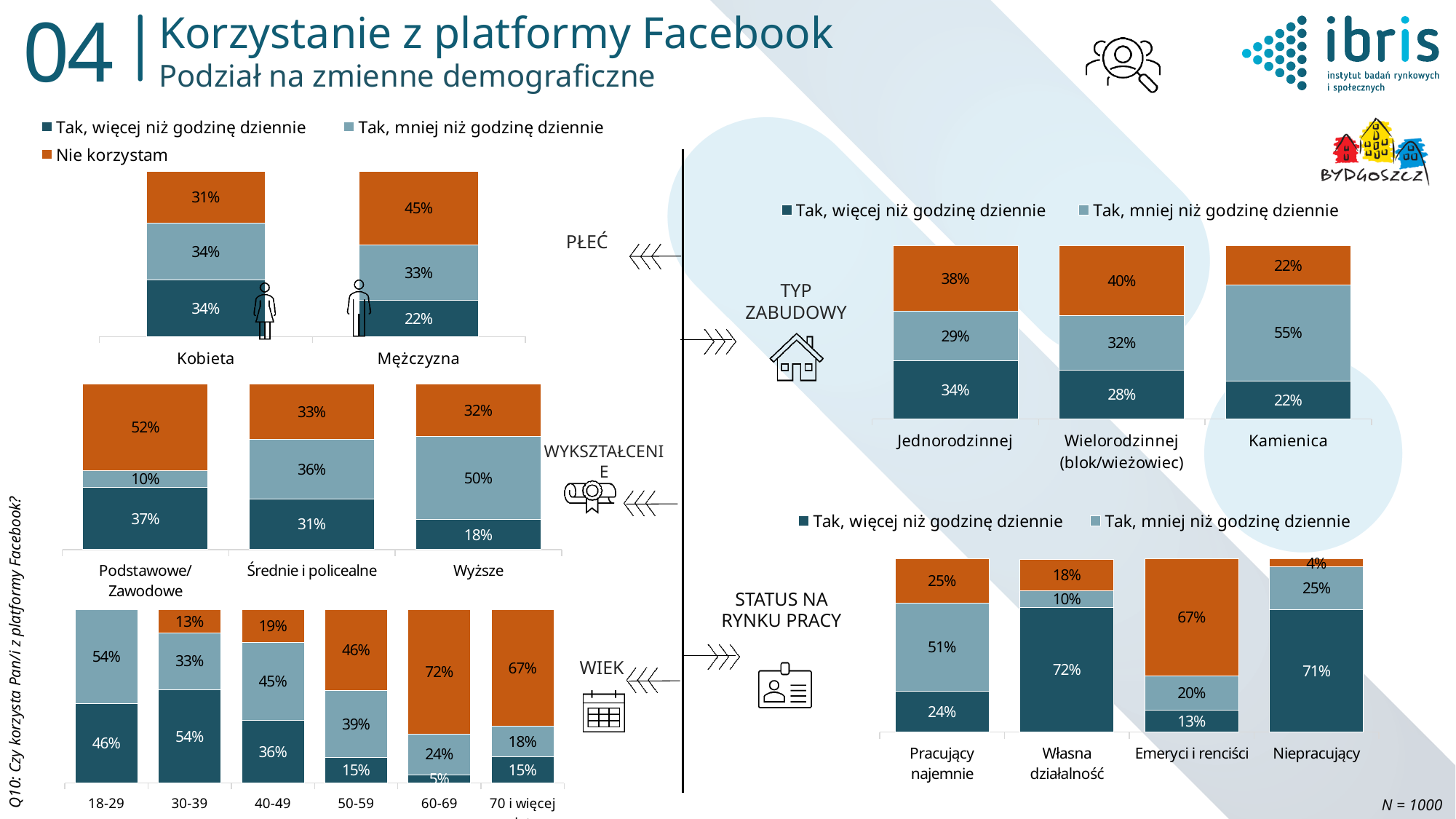
What kind of chart is used in the STATUS NA RYNKU PRACY section? Stacked bar chart In the WIEK chart, which age group has the highest share of 'Nie korzystam'? 60-69 In the WIEK chart, which has the larger share of 'Tak, więcej niż godzinę dziennie': 18-29 or 30-39? 30-39 In the STATUS NA RYNKU PRACY chart, which category has the lowest share of 'Tak, więcej niż godzinę dziennie'? Emeryci i renciści How many series does the legend above the PŁEĆ chart list? 3 In the STATUS NA RYNKU PRACY chart, what is the total of the three segments for Własna działalność? 100% In the WIEK chart, what is the value for 'Tak, więcej niż godzinę dziennie' in the 60-69 age group? 5% In the PŁEĆ chart, what percentage of Mężczyzna answered 'Nie korzystam'? 45% How many categories are shown in the TYP ZABUDOWY chart? 3 How many age groups are shown in the WIEK chart? 6 In the WYKSZTAŁCENIE chart, what is the value for 'Tak, mniej niż godzinę dziennie' in the Wyższe category? 50% In the TYP ZABUDOWY chart, how many percentage points higher is 'Tak, mniej niż godzinę dziennie' for Kamienica than for Jednorodzinnej? 26 percentage points